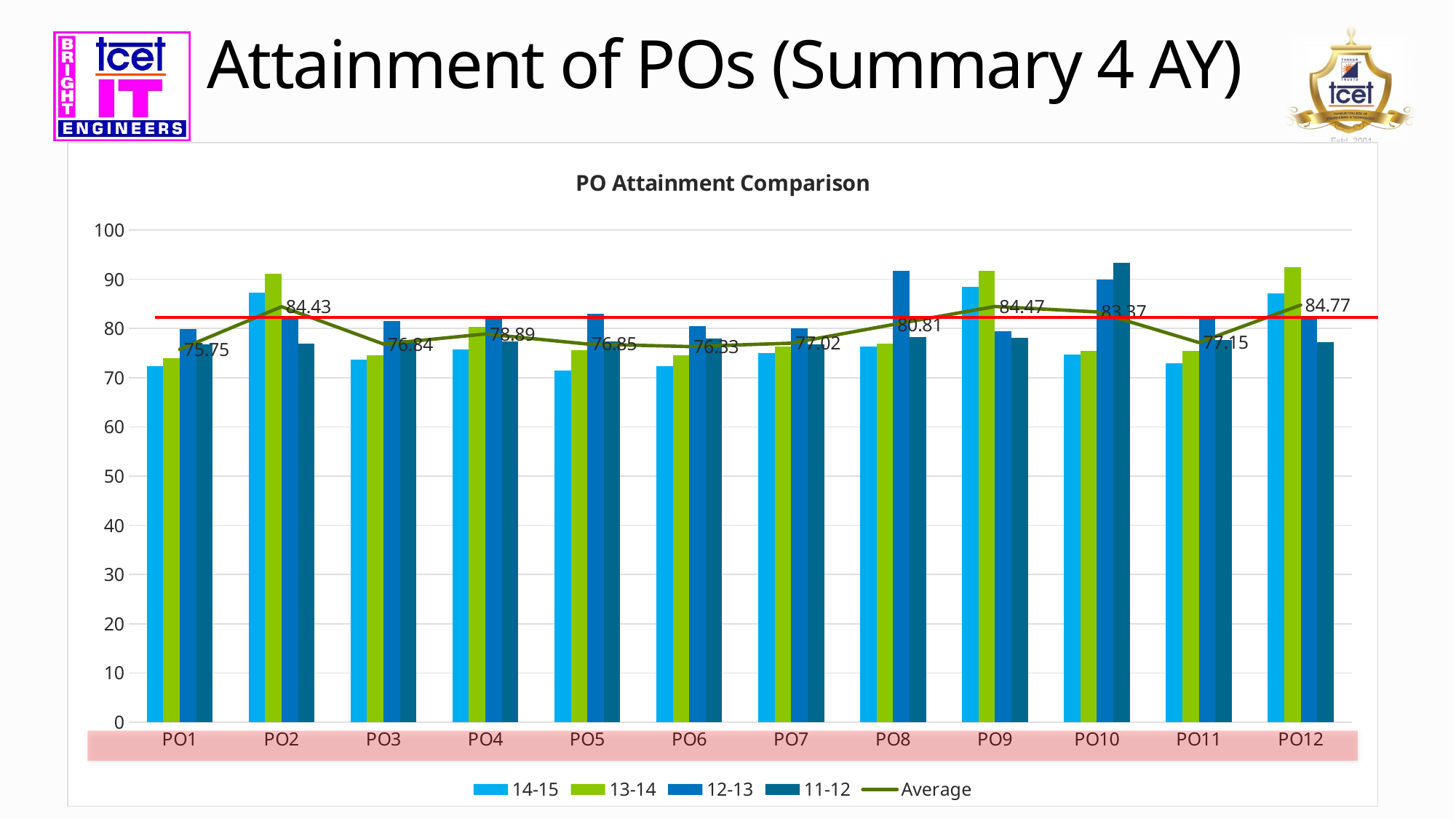
What kind of chart is shown on the slide? Bar chart with a line series What is the title of the chart? PO Attainment Comparison Is the 14-15 value for PO5 greater or less than 80? less Which PO has the lowest Average value? PO1 How many series does the legend list? 5 What is the Average value for PO9? 84.47 Which PO has the highest Average value? PO12 Which has a larger Average value, PO8 or PO7? PO8 Is the 13-14 value for PO2 greater or less than 90? greater What is the difference between the Average values for PO12 and PO1? 9.02 How many PO categories are shown on the x axis? 12 What is the Average value for PO1? 75.75